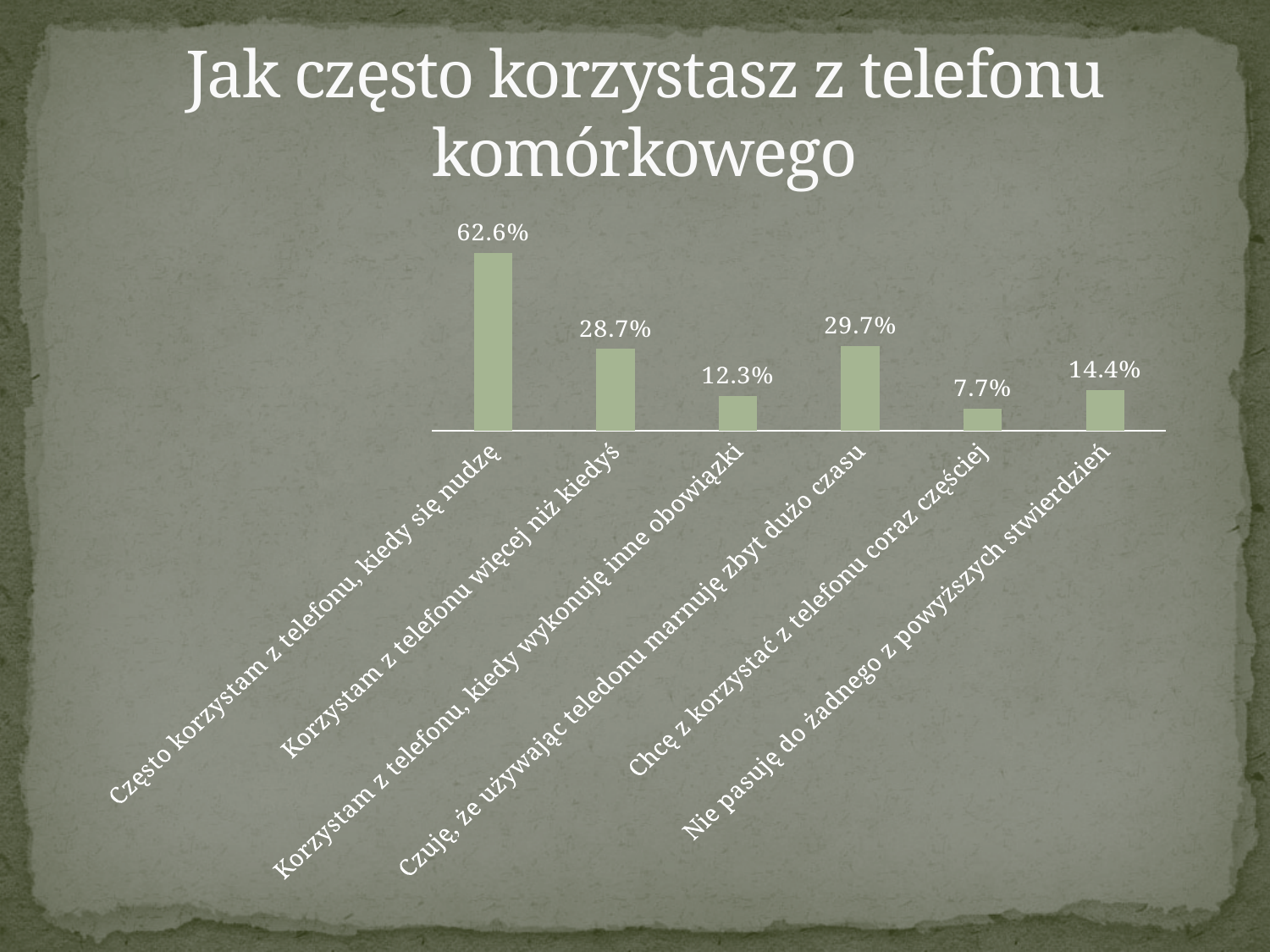
What is the difference between the values for "Często korzystam z telefonu, kiedy się nudzę" and "Czuję, że używając teledonu marnuję zbyt dużo czasu"? 32.9% What is the title of the chart? Jak często korzystasz z telefonu komórkowego What type of chart is shown on the slide? bar chart How many categories are shown in the chart? 6 What is the value for "Korzystam z telefonu, kiedy wykonuję inne obowiązki"? 12.3% What is the value for "Często korzystam z telefonu, kiedy się nudzę"? 62.6% Which category has the lowest value? Chcę z korzystać z telefonu coraz częściej What is the value for "Korzystam z telefonu więcej niż kiedyś"? 28.7% Which is larger: the value for "Nie pasuję do żadnego z powyższych stwierdzień" or the value for "Korzystam z telefonu, kiedy wykonuję inne obowiązki"? Nie pasuję do żadnego z powyższych stwierdzień Which category has the highest value? Często korzystam z telefonu, kiedy się nudzę What is the value for "Chcę z korzystać z telefonu coraz częściej"? 7.7% What is the value for "Nie pasuję do żadnego z powyższych stwierdzień"? 14.4%